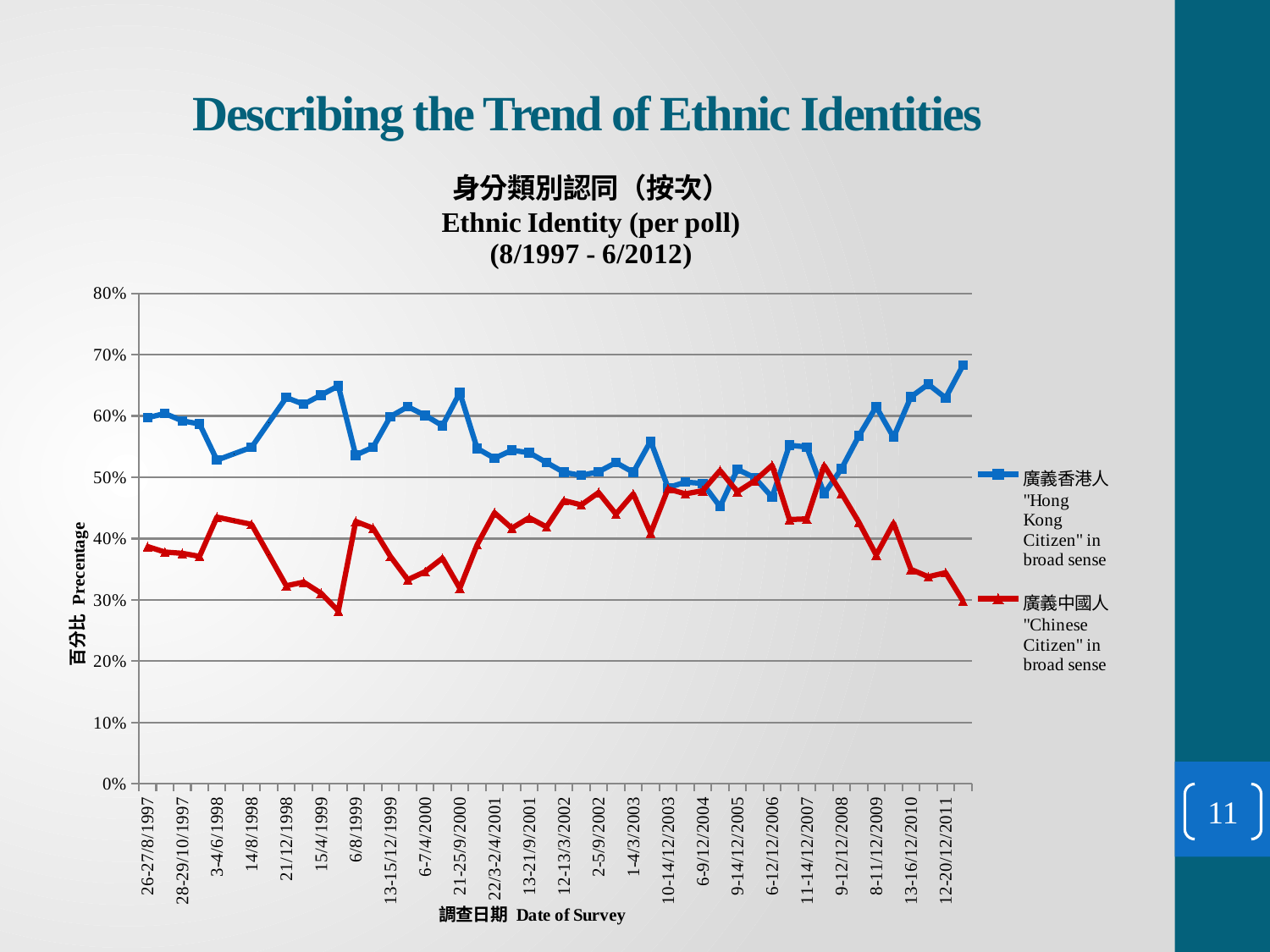
What is the label of the x axis? Date of Survey What kind of chart is shown on the slide? line chart Is the value for "Hong Kong Citizen" in broad sense at 3-4/6/1998 greater or less than 50%? greater Is the value for "Hong Kong Citizen" in broad sense at 12-20/12/2011 greater or less than 60%? greater Is the value for "Chinese Citizen" in broad sense at 26-27/8/1997 greater or less than 40%? less What is the English title of the chart? Ethnic Identity (per poll) (8/1997 - 6/2012) How many series does the legend list? 2 Overall, does the "Chinese Citizen" in broad sense series rise or fall from the first survey date to the last? fall At 26-27/8/1997, which series has the larger value: "Hong Kong Citizen" in broad sense or "Chinese Citizen" in broad sense? "Hong Kong Citizen" in broad sense